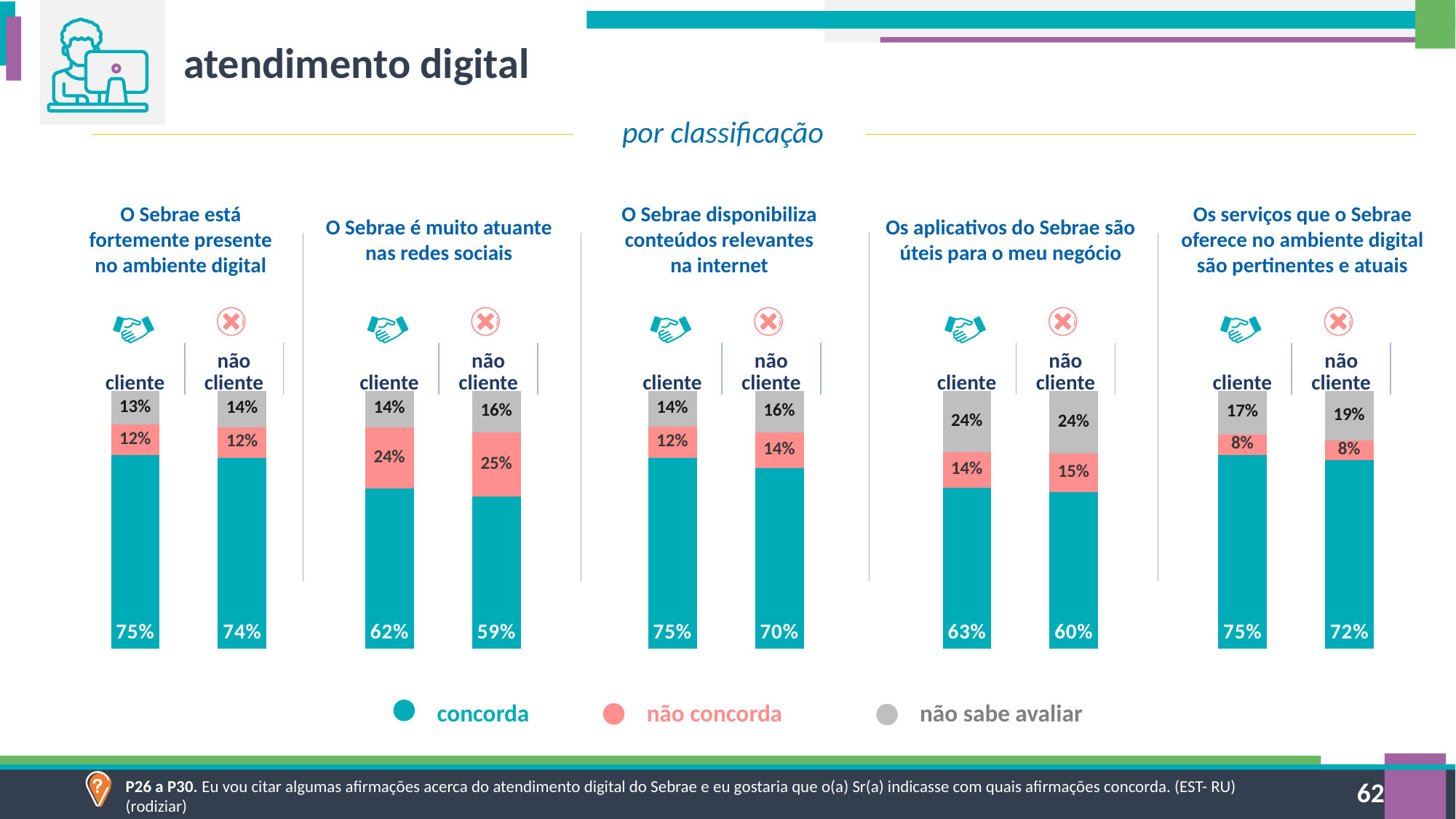
What kind of chart is used for 'O Sebrae está fortemente presente no ambiente digital'? Stacked bar chart How many bars are shown in the chart 'Os serviços que o Sebrae oferece no ambiente digital são pertinentes e atuais'? 2 Which colour represents 'não concorda' in the legend? Pink Across the five charts, which statement has the lowest concorda value for não cliente? O Sebrae é muito atuante nas redes sociais In the chart 'Os aplicativos do Sebrae são úteis para o meu negócio', what is the total of the stacked bar for não cliente? 99% In the chart 'Os serviços que o Sebrae oferece no ambiente digital são pertinentes e atuais', what is the concorda value for não cliente? 72% How many series does the legend at the bottom of the slide list? 3 In the chart 'Os aplicativos do Sebrae são úteis para o meu negócio', what is the não sabe avaliar value for cliente? 24% In the chart 'O Sebrae disponibiliza conteúdos relevantes na internet', what is the difference between the concorda values for cliente and não cliente? 5 percentage points In the chart 'O Sebrae é muito atuante nas redes sociais', which group has the higher concorda value, cliente or não cliente? cliente In the chart 'O Sebrae é muito atuante nas redes sociais', what is the não concorda value for não cliente? 25% In the chart 'O Sebrae está fortemente presente no ambiente digital', what percentage of cliente respondents concorda? 75%